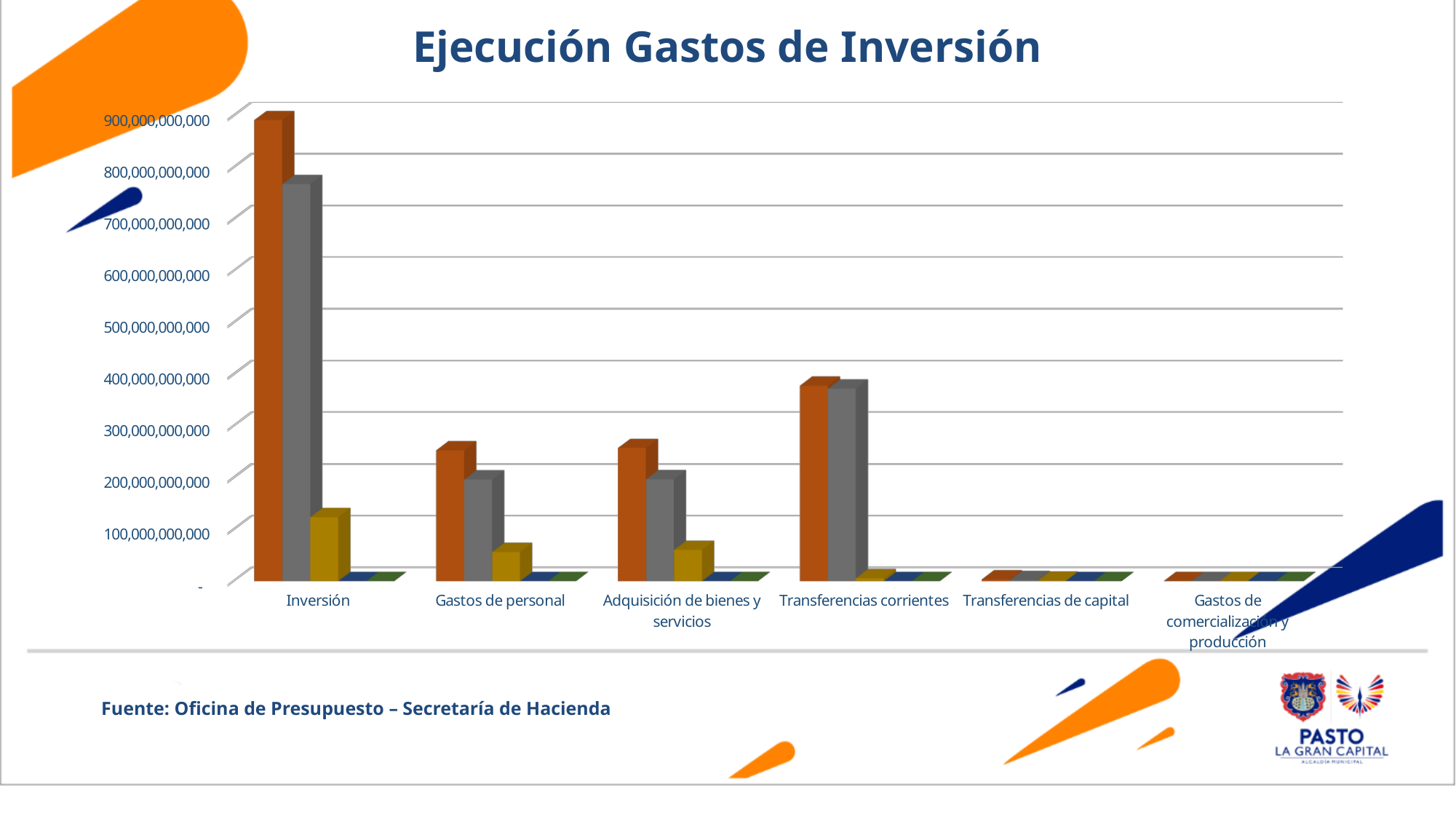
Which category has the tallest bar in the chart? Inversión How many categories are shown on the x axis of the chart? 6 Is the value of the tallest (orange) bar for Inversión greater or less than 800,000,000,000? greater Is the value of the gray bar for Inversión greater or less than 700,000,000,000? greater Which has the larger orange bar: Inversión or Transferencias corrientes? Inversión What is the title of the chart? Ejecución Gastos de Inversión Is the value of the yellow bar for Inversión greater or less than 100,000,000,000? greater Which has the larger orange bar: Transferencias corrientes or Gastos de personal? Transferencias corrientes What kind of chart is shown on the slide? bar chart What source is cited below the chart? Oficina de Presupuesto – Secretaría de Hacienda